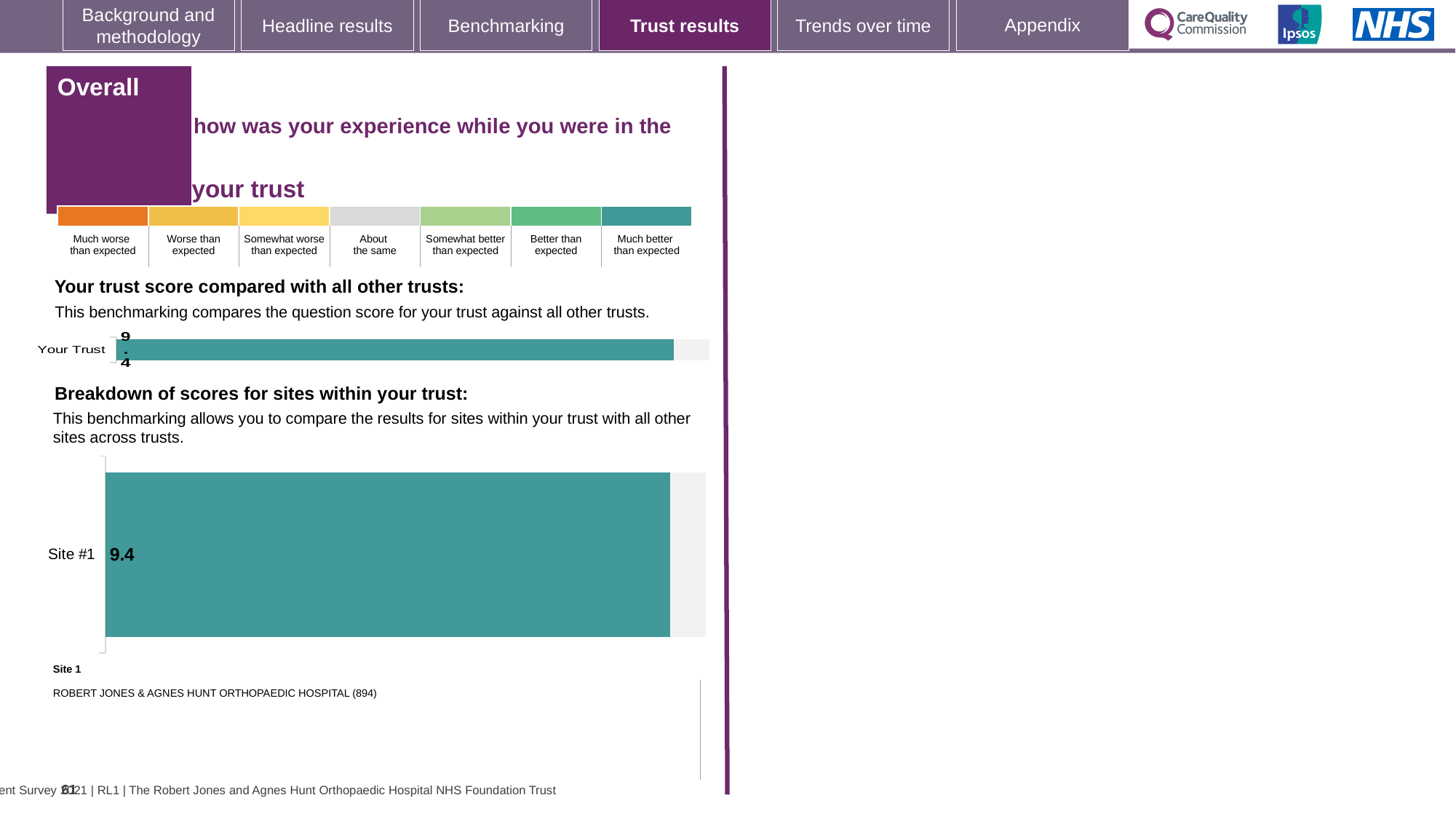
How many bars are plotted in the 'Your trust score compared with all other trusts' chart? 1 What is the difference between the Site #1 score in the breakdown chart and the Your Trust score in the trust comparison chart? 0 What is the label of the only bar in the 'Breakdown of scores for sites within your trust' chart? Site #1 In the 'Breakdown of scores for sites within your trust' chart, what is the value for Site #1? 9.4 What kind of chart is the 'Breakdown of scores for sites within your trust' chart? bar chart Is the value for Site #1 in the 'Breakdown of scores for sites within your trust' chart greater or less than 5? greater What is the label of the only bar in the 'Your trust score compared with all other trusts' chart? Your Trust Is the value for Your Trust in the 'Your trust score compared with all other trusts' chart greater or less than 9? greater How many sites are plotted in the 'Breakdown of scores for sites within your trust' chart? 1 In the 'Your trust score compared with all other trusts' chart, what is the value for Your Trust? 9.4 What kind of chart is the 'Your trust score compared with all other trusts' chart? bar chart